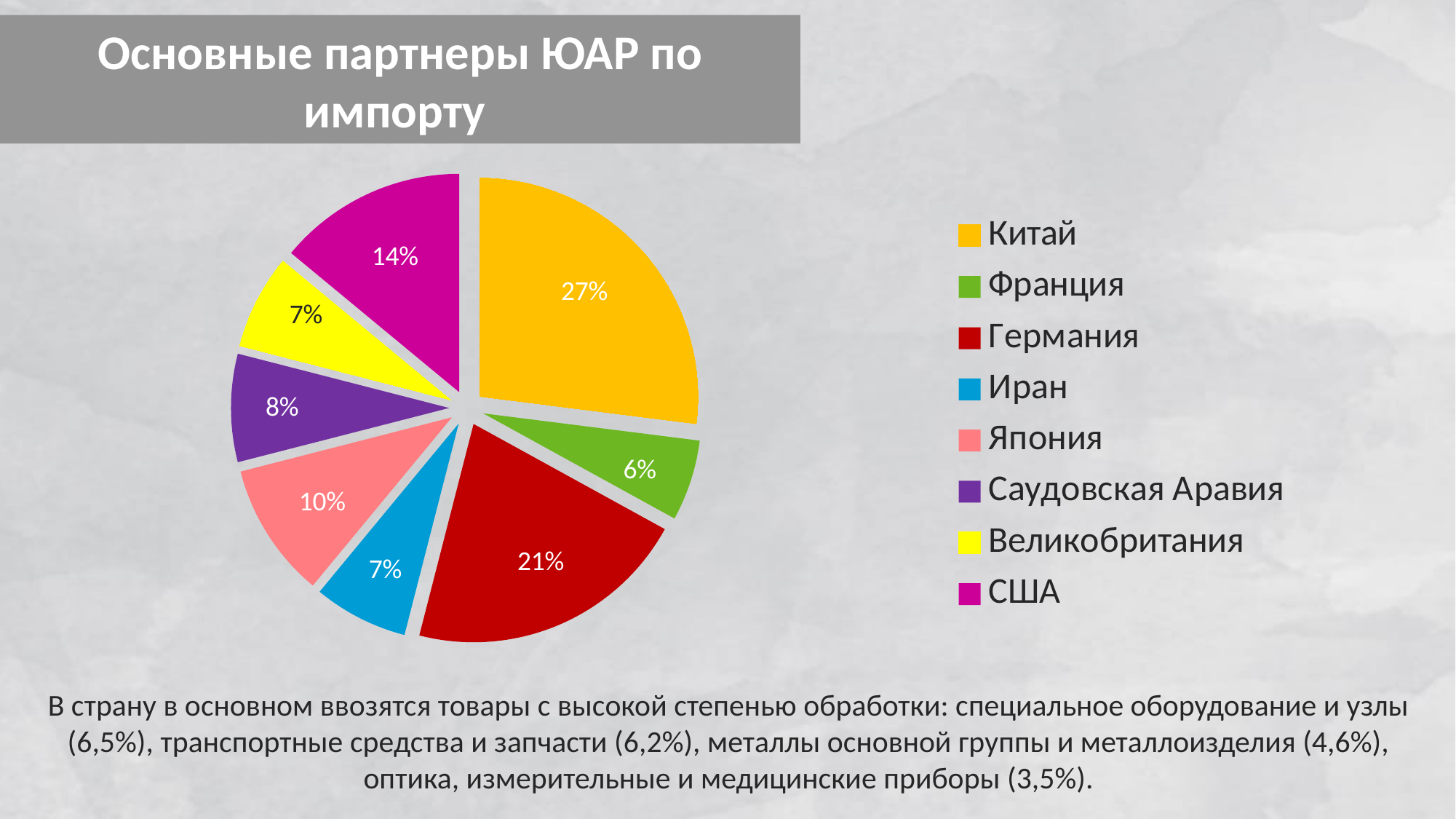
What share of the pie does Китай have? 27% Which country has the smallest slice of the pie? Франция What is the title of the chart? Основные партнеры ЮАР по импорту Which country is represented by the yellow slice? Великобритания What is the value for Япония? 10% How many countries are shown in the pie chart? 8 What is the difference between the shares of Китай and Германия? 6% What percentage is shown for США? 14% What type of chart is shown on the slide? Pie chart Which country has the largest slice of the pie? Китай What is the value shown for Германия? 21% Which is larger, the share of Саудовская Аравия or the share of Япония? Япония